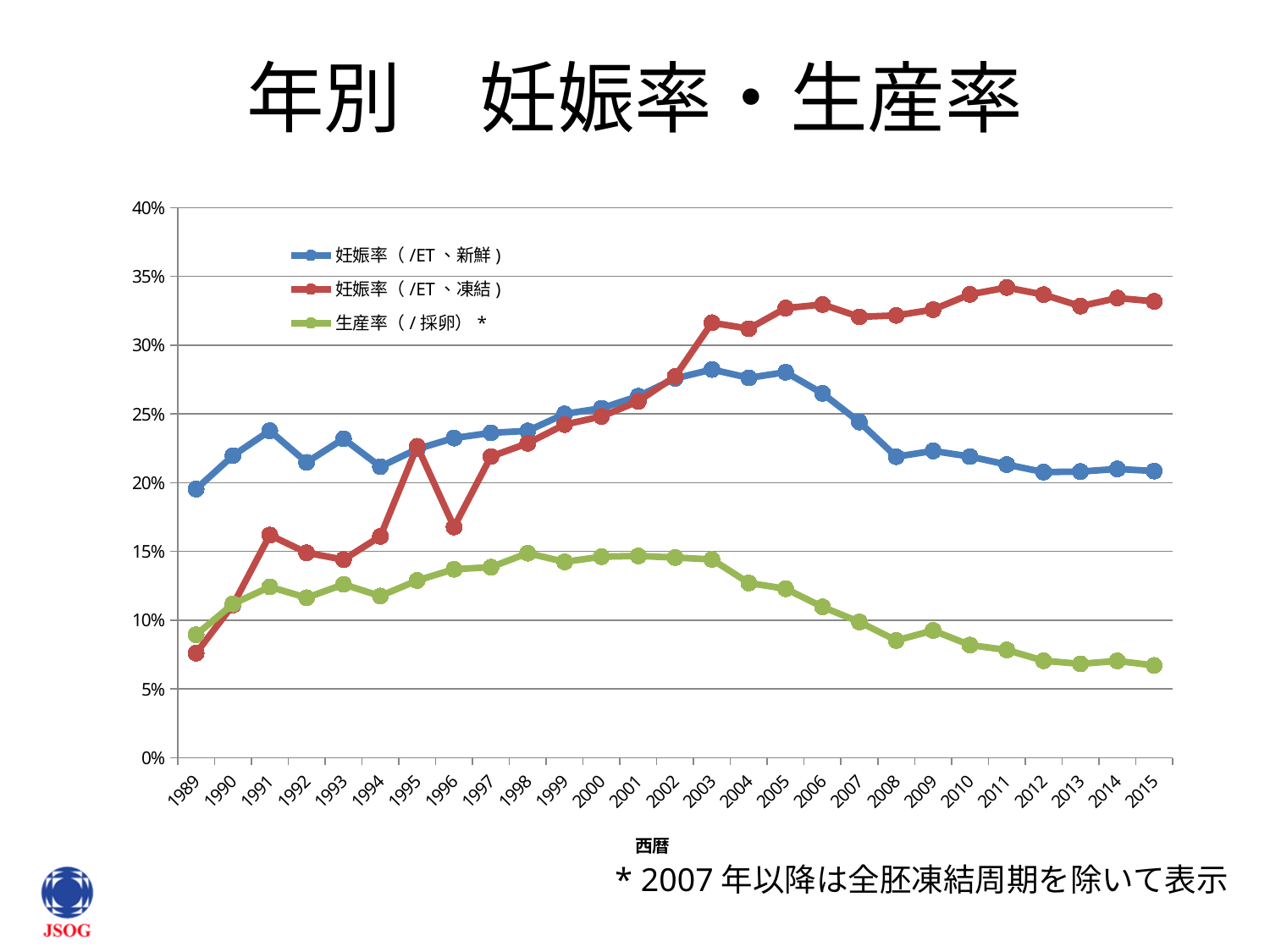
Which series has the highest value in 2010? 妊娠率（/ET、凍結） Does 生産率（/採卵）* rise or fall from 2003 to 2015? fall How many years are plotted along the x axis? 27 What kind of chart is shown on the slide? line chart Is the value for 妊娠率（/ET、凍結） in 2011 greater or less than 30%? greater In 2015, which is higher: 妊娠率（/ET、新鮮） or 妊娠率（/ET、凍結）? 妊娠率（/ET、凍結） In which year is 妊娠率（/ET、凍結） at its lowest? 1989 Is the value for 妊娠率（/ET、新鮮） in 2003 greater or less than 25%? greater In 1989, which is higher: 妊娠率（/ET、新鮮） or 妊娠率（/ET、凍結）? 妊娠率（/ET、新鮮） How many series does the legend list? 3 What is the x-axis title of the chart? 西暦 Is the value for 生産率（/採卵）* in 2015 greater or less than 10%? less